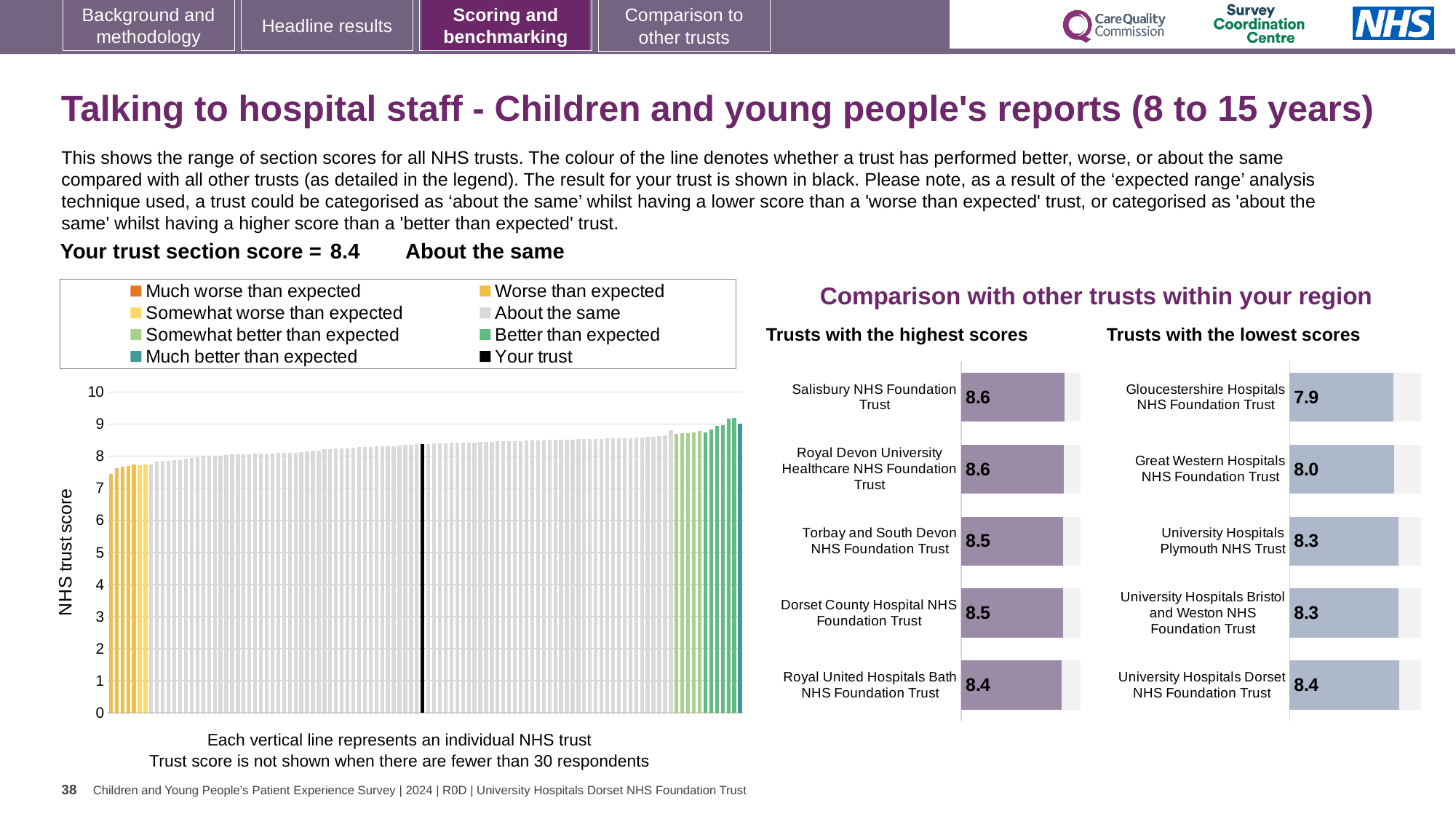
In the 'Trusts with the lowest scores' chart, what is the difference between the scores of University Hospitals Dorset NHS Foundation Trust and Gloucestershire Hospitals NHS Foundation Trust? 0.5 In the 'Trusts with the lowest scores' chart, which has the larger score: Great Western Hospitals NHS Foundation Trust or University Hospitals Plymouth NHS Trust? University Hospitals Plymouth NHS Trust How many entries does the legend of the large 'NHS trust score' chart on the left list? 8 What kind of chart is the large chart on the left with the y-axis labelled 'NHS trust score'? Bar chart In the 'Trusts with the highest scores' chart, what is the difference between the scores of Salisbury NHS Foundation Trust and Royal United Hospitals Bath NHS Foundation Trust? 0.2 In the 'Trusts with the lowest scores' chart, what is the score for Gloucestershire Hospitals NHS Foundation Trust? 7.9 In the large 'NHS trust score' chart on the left, do the bar values rise or fall from left to right? Rise In the 'Trusts with the highest scores' chart, what is the score for Salisbury NHS Foundation Trust? 8.6 In the 'Trusts with the highest scores' chart, what is the score for Royal United Hospitals Bath NHS Foundation Trust? 8.4 In the 'Trusts with the lowest scores' chart, which trust has the lowest score? Gloucestershire Hospitals NHS Foundation Trust In the 'Trusts with the lowest scores' chart, which trust has the highest score? University Hospitals Dorset NHS Foundation Trust How many trusts are listed in the 'Trusts with the highest scores' chart? 5